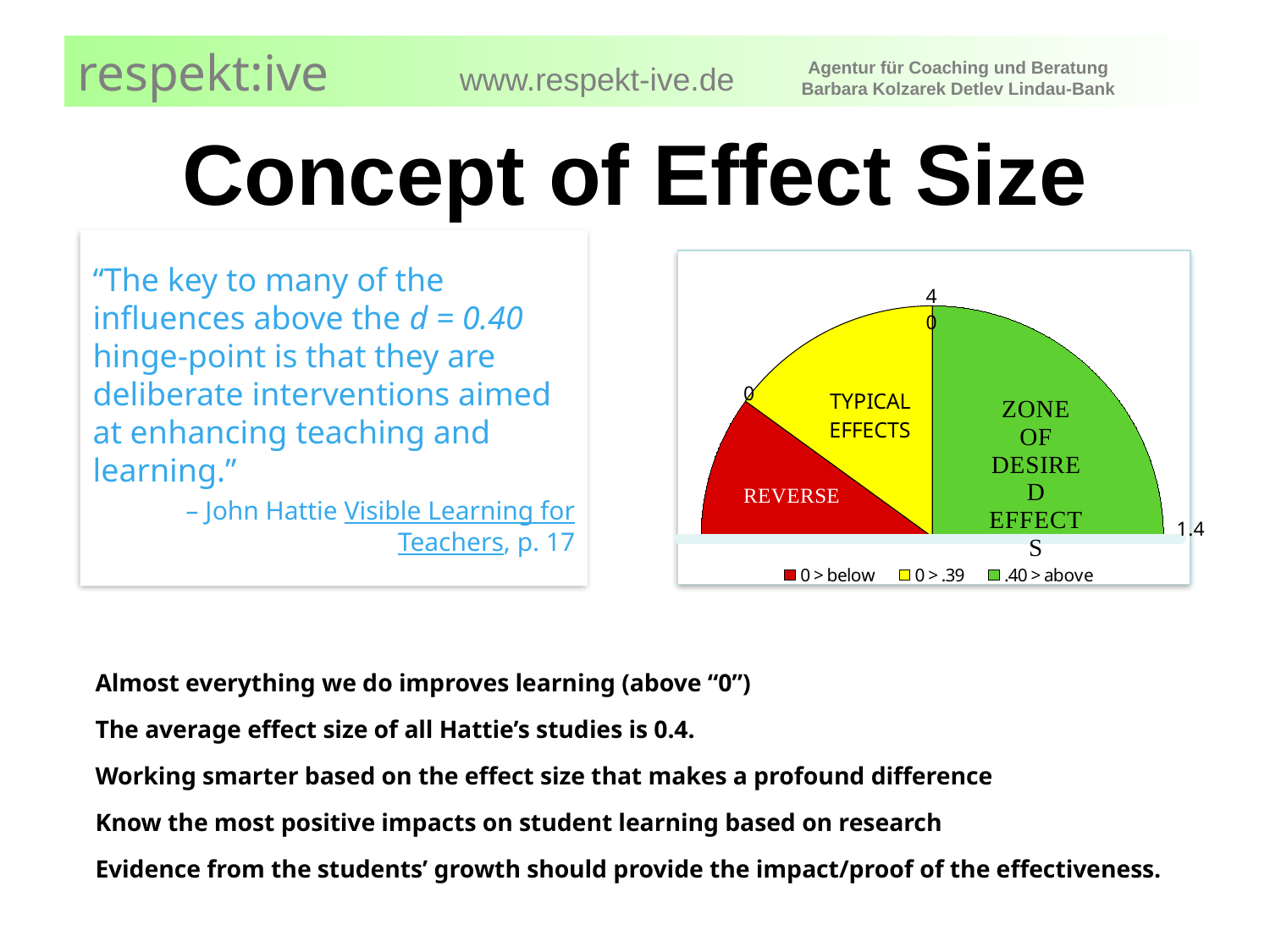
What is the label of the yellow segment of the chart? TYPICAL EFFECTS What colour is the REVERSE segment of the chart? red What kind of chart is shown on the slide? pie chart Which legend entry corresponds to the green segment of the chart? .40 > above Which segment is larger, REVERSE or TYPICAL EFFECTS? TYPICAL EFFECTS Which segment is larger, TYPICAL EFFECTS or ZONE OF DESIRED EFFECTS? ZONE OF DESIRED EFFECTS How many entries does the chart's legend list? 3 Which segment of the chart is the smallest? REVERSE How many segments does the chart have? 3 Which segment of the chart is the largest? ZONE OF DESIRED EFFECTS What value is printed at the right end of the chart's arc? 1.4